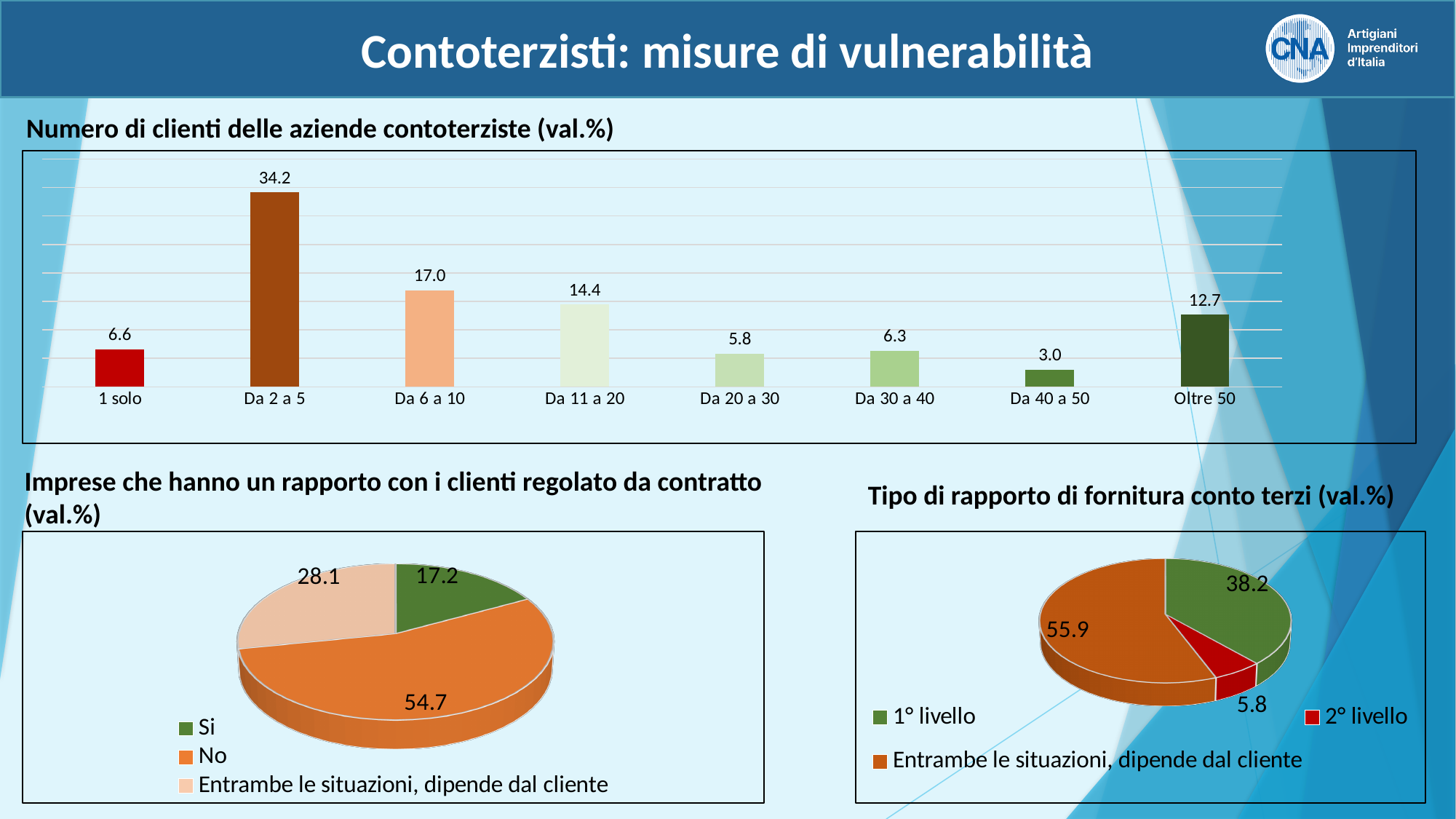
In the chart 'Numero di clienti delle aziende contoterziste (val.%)', what is the difference between the values for 'Da 6 a 10' and 'Da 11 a 20'? 2.6 In the chart 'Numero di clienti delle aziende contoterziste (val.%)', which category has the highest value? Da 2 a 5 How many entries does the legend of the pie chart 'Tipo di rapporto di fornitura conto terzi (val.%)' list? 3 In the chart 'Numero di clienti delle aziende contoterziste (val.%)', how many categories are shown? 8 In the chart 'Numero di clienti delle aziende contoterziste (val.%)', what is the value for 'Oltre 50'? 12.7 In the pie chart 'Imprese che hanno un rapporto con i clienti regolato da contratto (val.%)', what is the value for 'No'? 54.7 In the pie chart 'Imprese che hanno un rapporto con i clienti regolato da contratto (val.%)', which is larger: 'Si' or 'Entrambe le situazioni, dipende dal cliente'? Entrambe le situazioni, dipende dal cliente In the chart 'Numero di clienti delle aziende contoterziste (val.%)', what is the value for 'Da 2 a 5'? 34.2 In the pie chart 'Tipo di rapporto di fornitura conto terzi (val.%)', which category has the largest share? Entrambe le situazioni, dipende dal cliente In the chart 'Numero di clienti delle aziende contoterziste (val.%)', which category has the lowest value? Da 40 a 50 In the pie chart 'Tipo di rapporto di fornitura conto terzi (val.%)', what is the value for '2° livello'? 5.8 What kind of chart is 'Numero di clienti delle aziende contoterziste (val.%)'? Bar chart